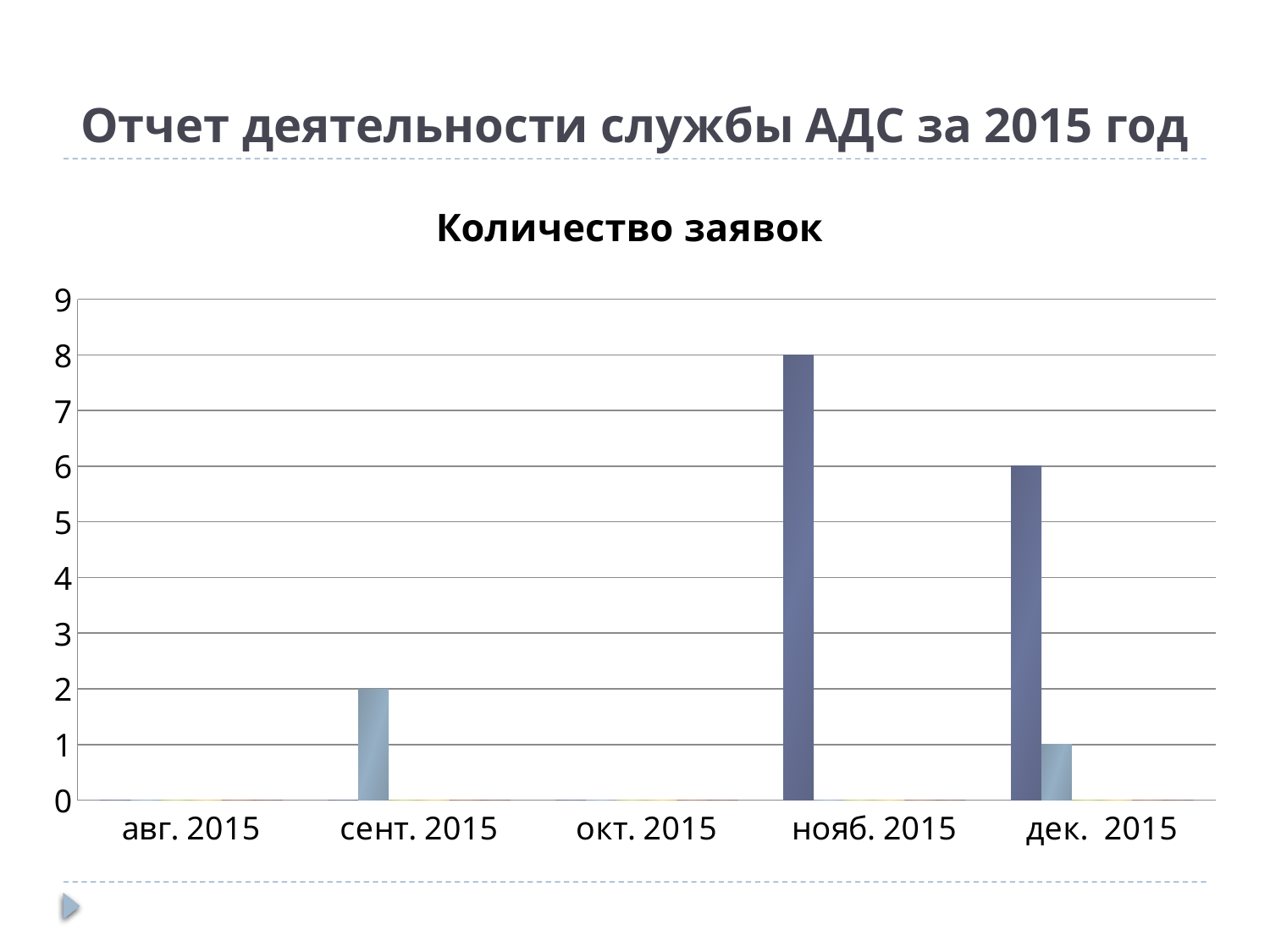
What type of chart is shown on the slide? bar chart What is the value of the dark blue bar for дек. 2015? 6 What is the title of the chart? Количество заявок Which month has the tallest bar in the chart? нояб. 2015 What is the highest value shown on the y axis of the chart? 9 What is the value of the dark blue bar for нояб. 2015? 8 How many categories are shown on the x axis of the chart? 5 What is the difference between the dark blue bar for нояб. 2015 and the dark blue bar for дек. 2015? 2 Which is larger: the dark blue bar for нояб. 2015 or the dark blue bar for дек. 2015? нояб. 2015 What is the value of the light blue bar for дек. 2015? 1 Is the value of the dark blue bar for нояб. 2015 greater or less than 5? greater What is the value of the light blue bar for сент. 2015? 2